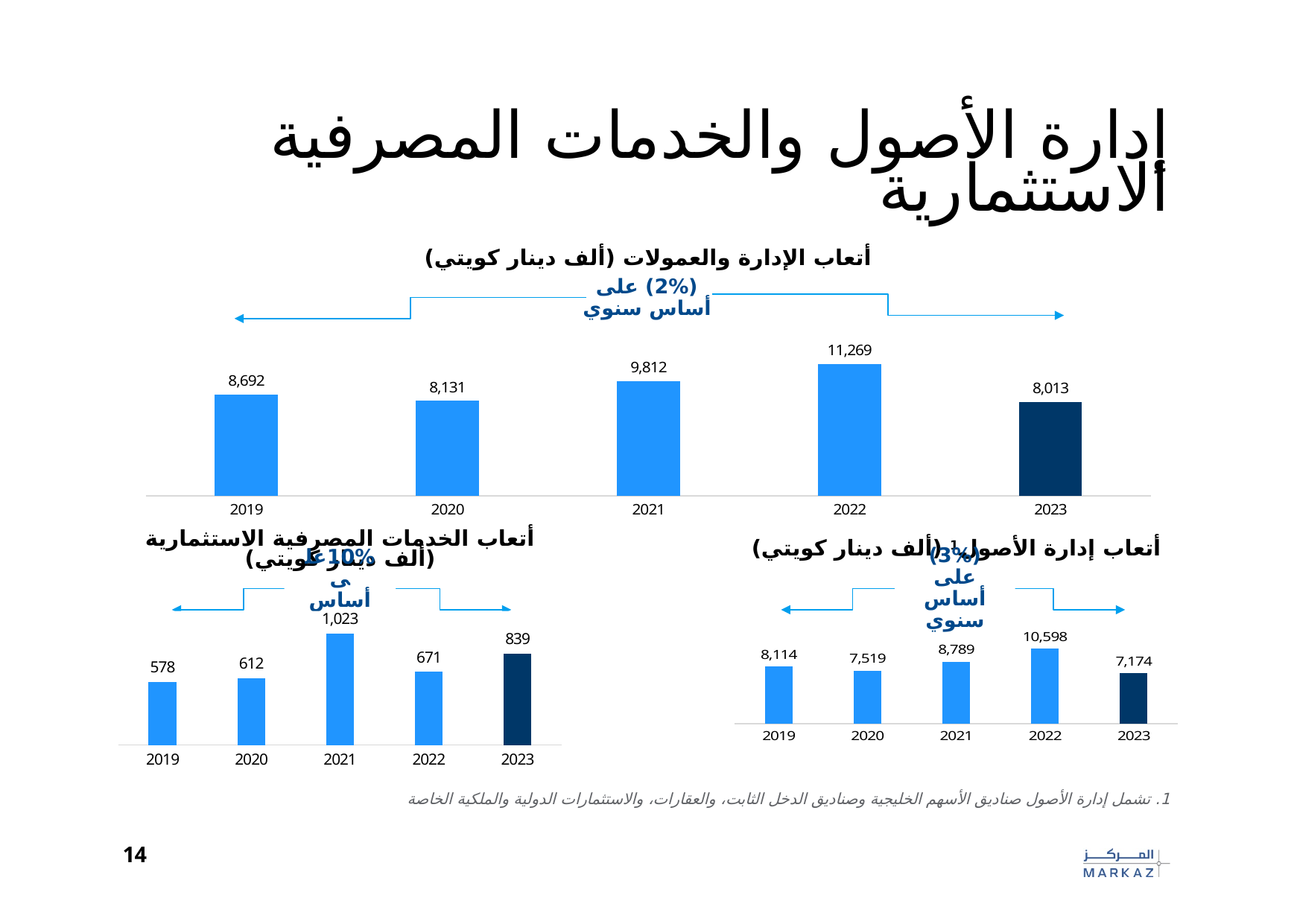
In the top chart (management fees and commissions), what is the value for 2022? 11,269 In the bottom-left chart (investment banking fees), which year has the highest value? 2021 In the bottom-right chart (asset management fees), what is the difference between the 2019 and 2023 values? 940 In the top chart (management fees and commissions), what is the difference between the 2022 and 2023 values? 3,256 In the bottom-left chart (investment banking fees), what is the difference between the 2023 and 2022 values? 168 In the bottom-right chart (asset management fees), what is the value for 2020? 7,519 What type of chart is the top chart (management fees and commissions)? Bar chart In the bottom-left chart (investment banking fees), is the value for 2022 or 2023 larger? 2023 In the bottom-left chart (investment banking fees), what is the value for 2021? 1,023 In the top chart (management fees and commissions), how many years are plotted? 5 In the bottom-right chart (asset management fees), which year has the highest value? 2022 In the top chart (management fees and commissions), which year has the lowest value? 2023